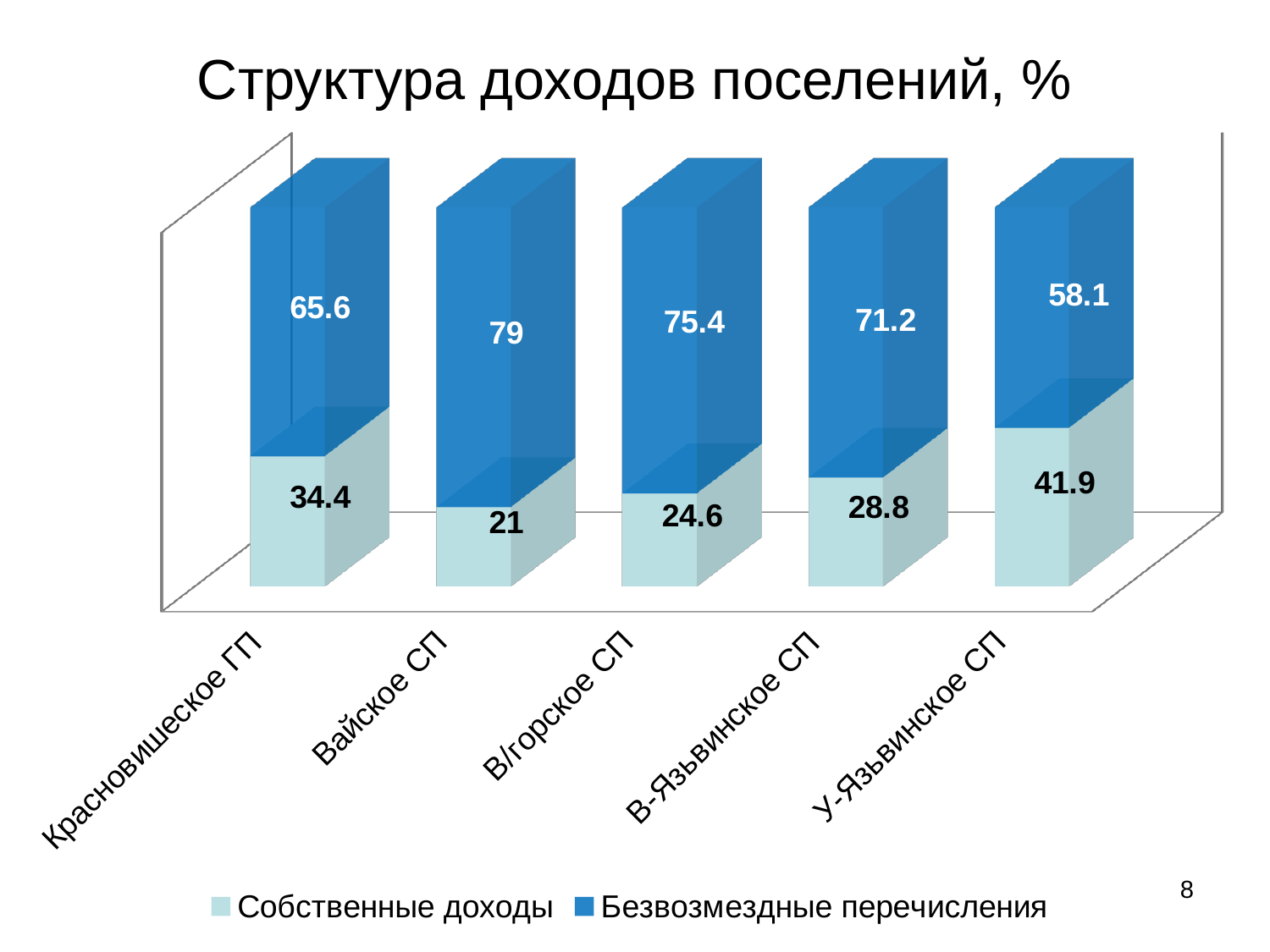
How many categories are shown on the x axis? 5 Which category has the highest value for Собственные доходы? У-Язьвинское СП What is the title of the chart? Структура доходов поселений, % Which category has the lowest value for Собственные доходы? Вайское СП What is the difference between Безвозмездные перечисления and Собственные доходы for В/горское СП? 50.8 What is the value of Собственные доходы for Вайское СП? 21 Which is larger for В-Язьвинское СП: Собственные доходы or Безвозмездные перечисления? Безвозмездные перечисления What kind of chart is shown on the slide? Stacked bar chart How many series does the legend list? 2 What is the value of Безвозмездные перечисления for У-Язьвинское СП? 58.1 What is the value of Безвозмездные перечисления for Красновишерское ГП? 65.6 Which category has the highest value for Безвозмездные перечисления? Вайское СП